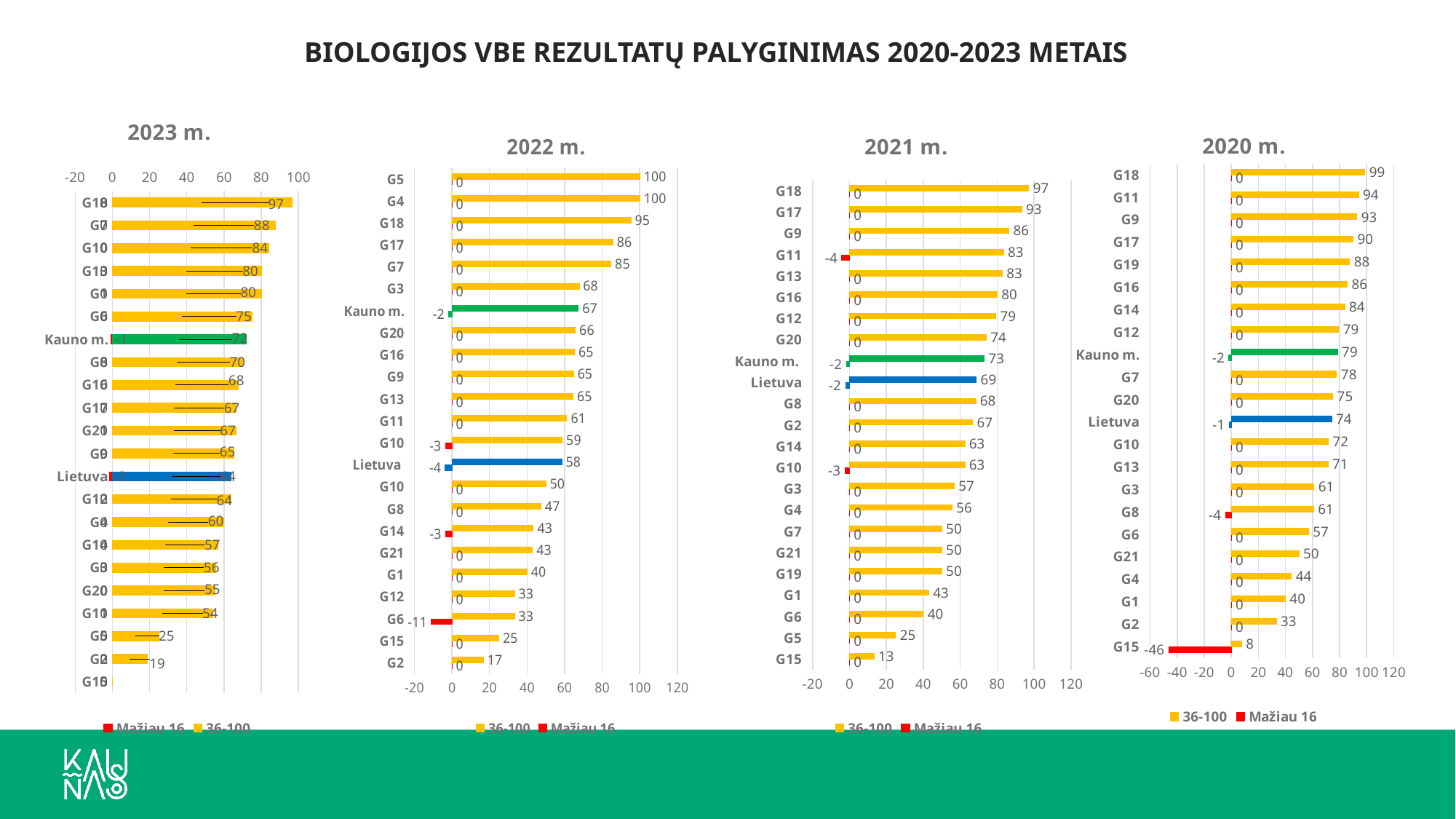
In the 2022 m. chart, what is the 36-100 value for Kauno m.? 67 In the 2021 m. chart, what is the 36-100 value for Lietuva? 69 In the 2020 m. chart, what is the Mažiau 16 value for G15? -46 What type of chart is the 2022 m. chart? Bar chart How many series does the legend of the 2020 m. chart list? 2 In the 2020 m. chart, what is the difference between the 36-100 values of Kauno m. and Lietuva? 5 In the 2023 m. chart, what is the 36-100 value for Kauno m.? 72 In the 2022 m. chart, what is the Mažiau 16 value for G6? -11 In the 2020 m. chart, which category has the highest 36-100 value? G18 In the 2021 m. chart, which has a higher 36-100 value, G18 or G9? G18 In the 2021 m. chart, which category has the lowest 36-100 value? G15 In the 2022 m. chart, what is the difference between the 36-100 values of G5 and G2? 83